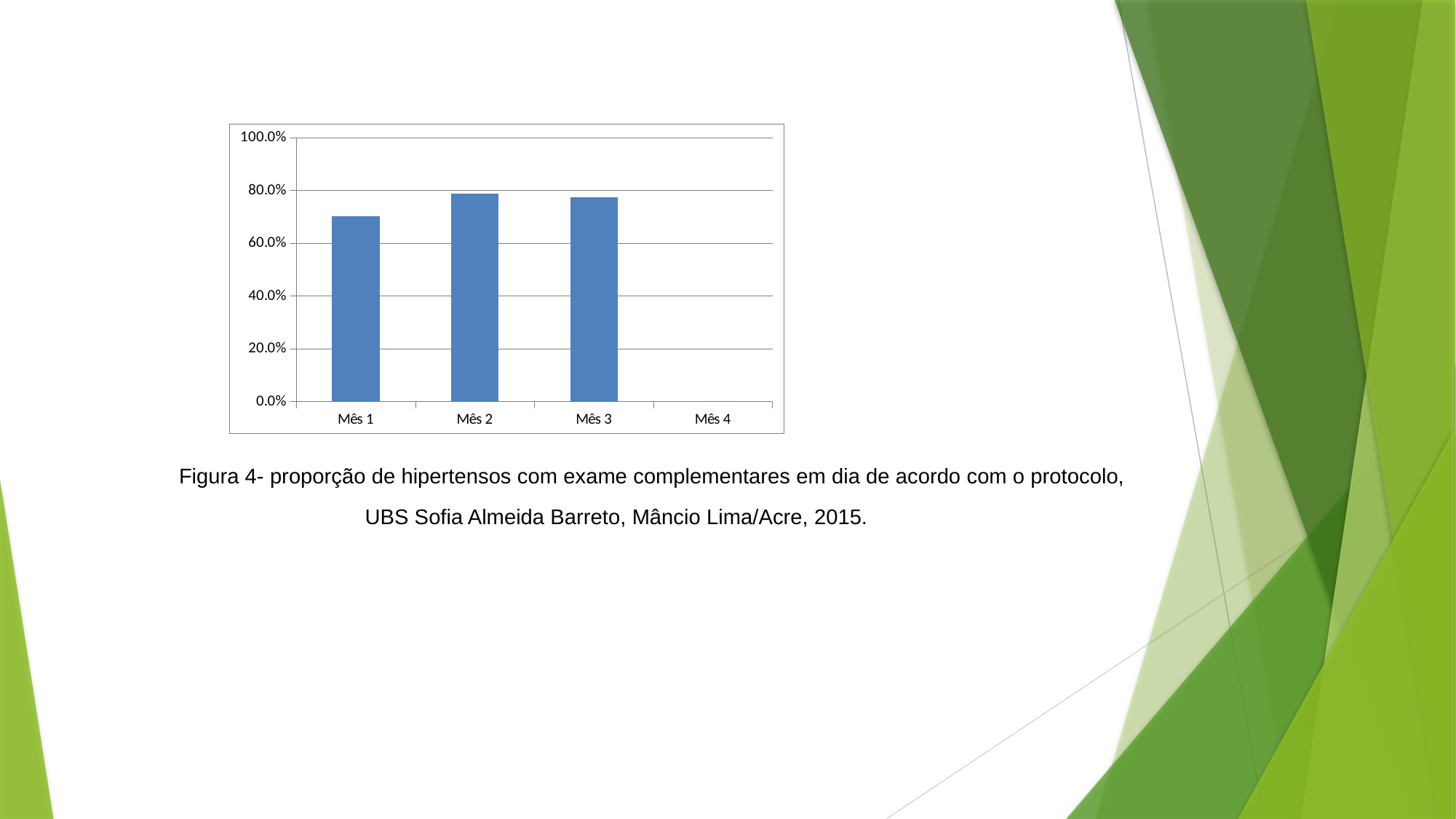
Is the value for Mês 1 greater or less than 80.0%? less Does the value rise or fall from Mês 1 to Mês 2? rise Is the value for Mês 3 greater or less than 60.0%? greater What is the highest value shown on the y axis of the chart? 100.0% Which is larger, the value for Mês 1 or the value for Mês 2? Mês 2 How many categories are shown on the x axis of the chart? 4 Is the value for Mês 3 greater or less than 100.0%? less What kind of chart is shown on the slide? bar chart Which category on the x axis has no bar plotted? Mês 4 Which is larger, the value for Mês 1 or the value for Mês 3? Mês 3